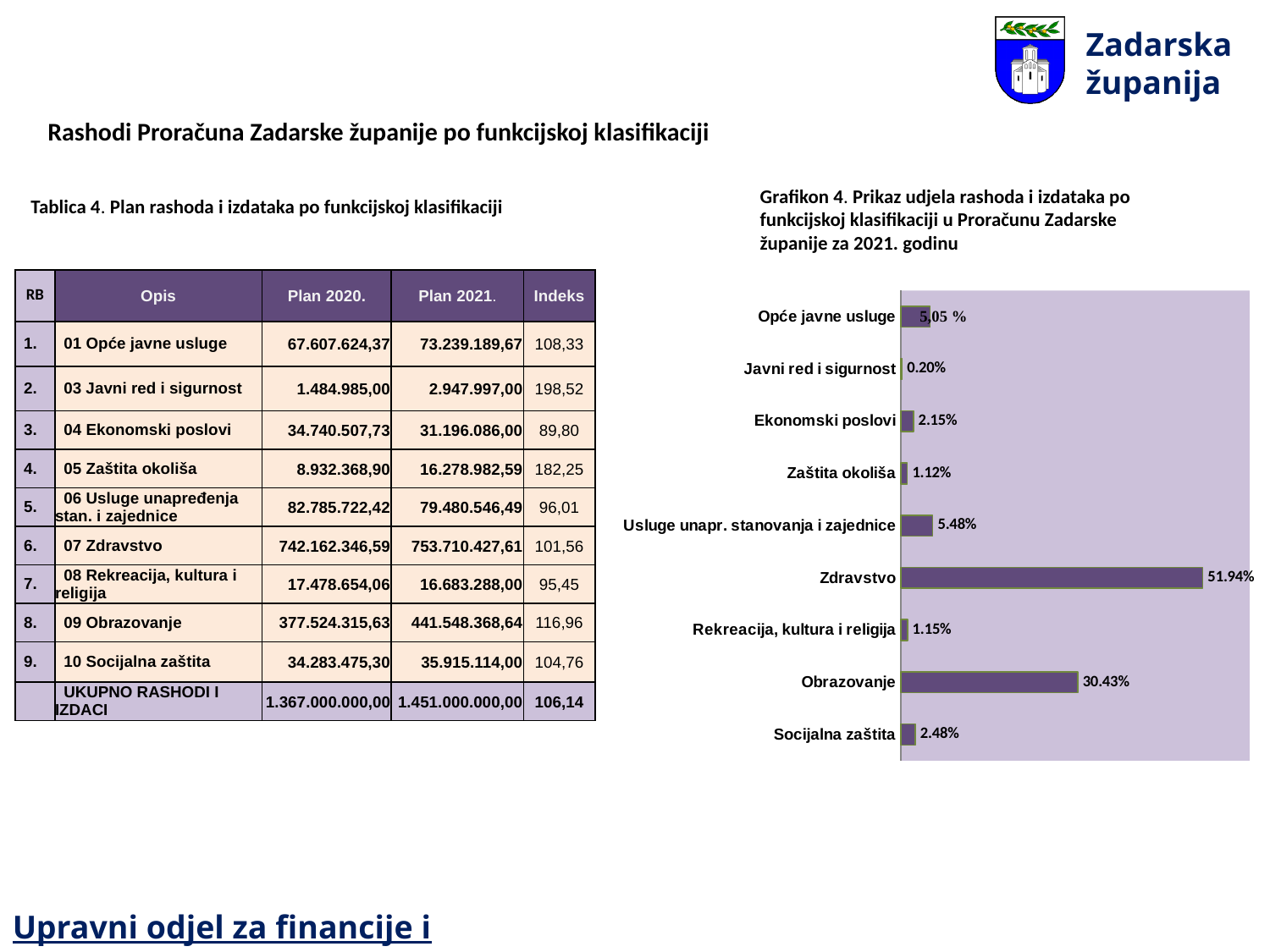
What is the share shown for Socijalna zaštita in the bar chart? 2.48% What is the title of the bar chart on the slide? Grafikon 4. Prikaz udjela rashoda i izdataka po funkcijskoj klasifikaciji u Proračunu Zadarske županije za 2021. godinu What is the share shown for Obrazovanje in the bar chart? 30.43% What is the difference between the shares of Socijalna zaštita and Ekonomski poslovi in the bar chart? 0.33% Which category has the highest share in the bar chart? Zdravstvo What is the share shown for Zdravstvo in the bar chart? 51.94% What type of chart is shown on the slide? bar chart Which category has the lowest share in the bar chart? Javni red i sigurnost What is the difference between the shares of Zdravstvo and Obrazovanje in the bar chart? 21.51% What is the share shown for Usluge unapr. stanovanja i zajednice in the bar chart? 5.48% How many categories does the bar chart show? 9 Which has a larger share in the bar chart, Ekonomski poslovi or Zaštita okoliša? Ekonomski poslovi